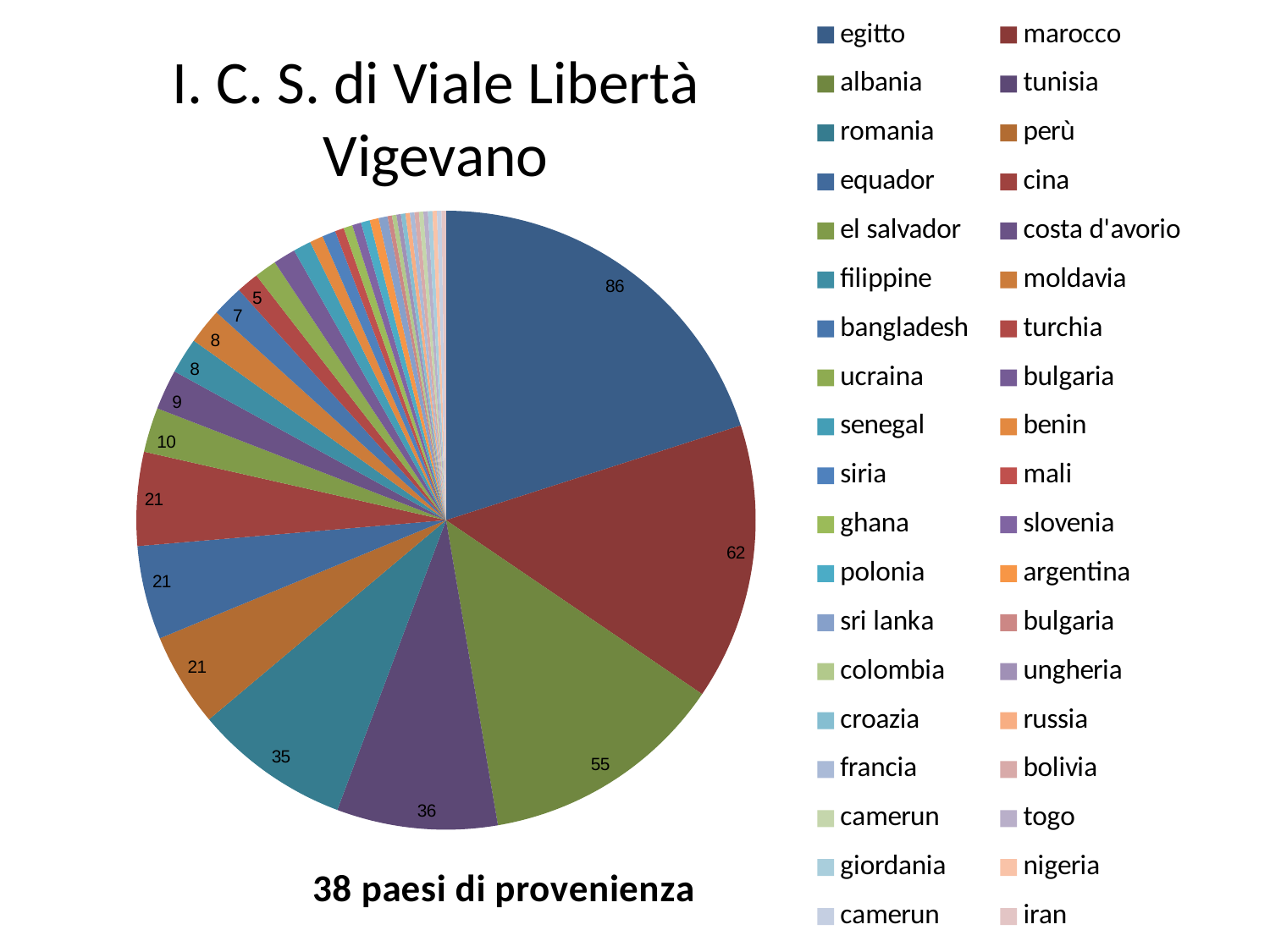
What is the value shown for egitto? 86 What kind of chart is shown on the slide? pie chart What is the value shown for marocco? 62 What is the difference between the values for egitto and marocco? 24 Which country has the largest slice of the pie? egitto What is the value shown for romania? 35 What is the value shown for albania? 55 What is the title of the chart? 38 paesi di provenienza What is the value shown for el salvador? 10 What is the value shown for tunisia? 36 How many countries of origin does the chart show? 38 Which has the larger value, tunisia or romania? tunisia